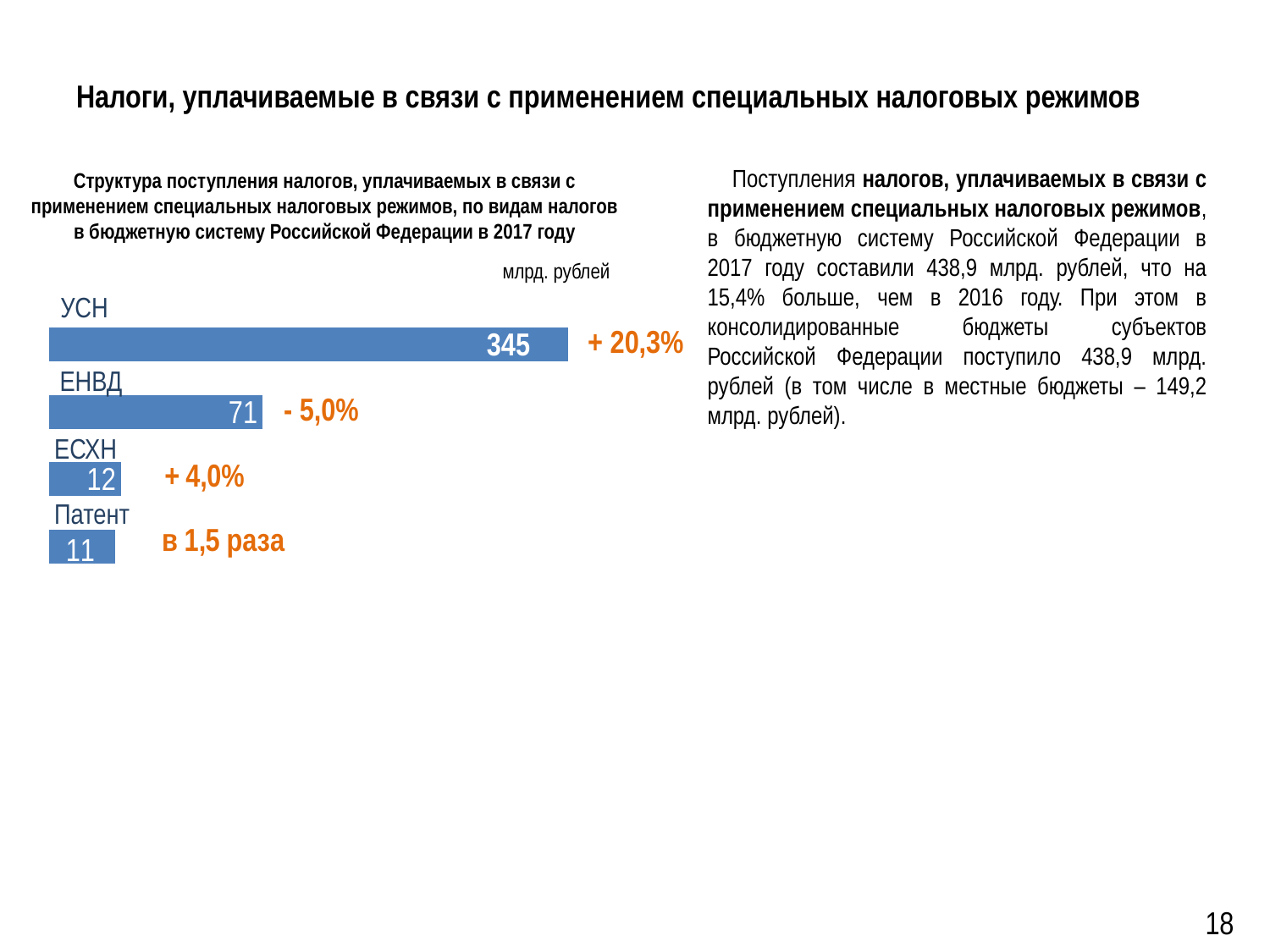
What is the value for Патент? 11 What is the value for ЕНВД? 71 What is the value for ЕСХН? 12 What percentage change is shown next to the УСН bar? + 20,3% What kind of chart is shown on the slide? Bar chart Which category has the lowest value? Патент What unit of measurement is indicated for the chart values? млрд. рублей Which category has the highest value? УСН What is the value for УСН? 345 How many categories are shown in the chart? 4 Which is larger, the value for ЕНВД or the value for ЕСХН? ЕНВД What is the difference between the values for УСН and ЕНВД? 274